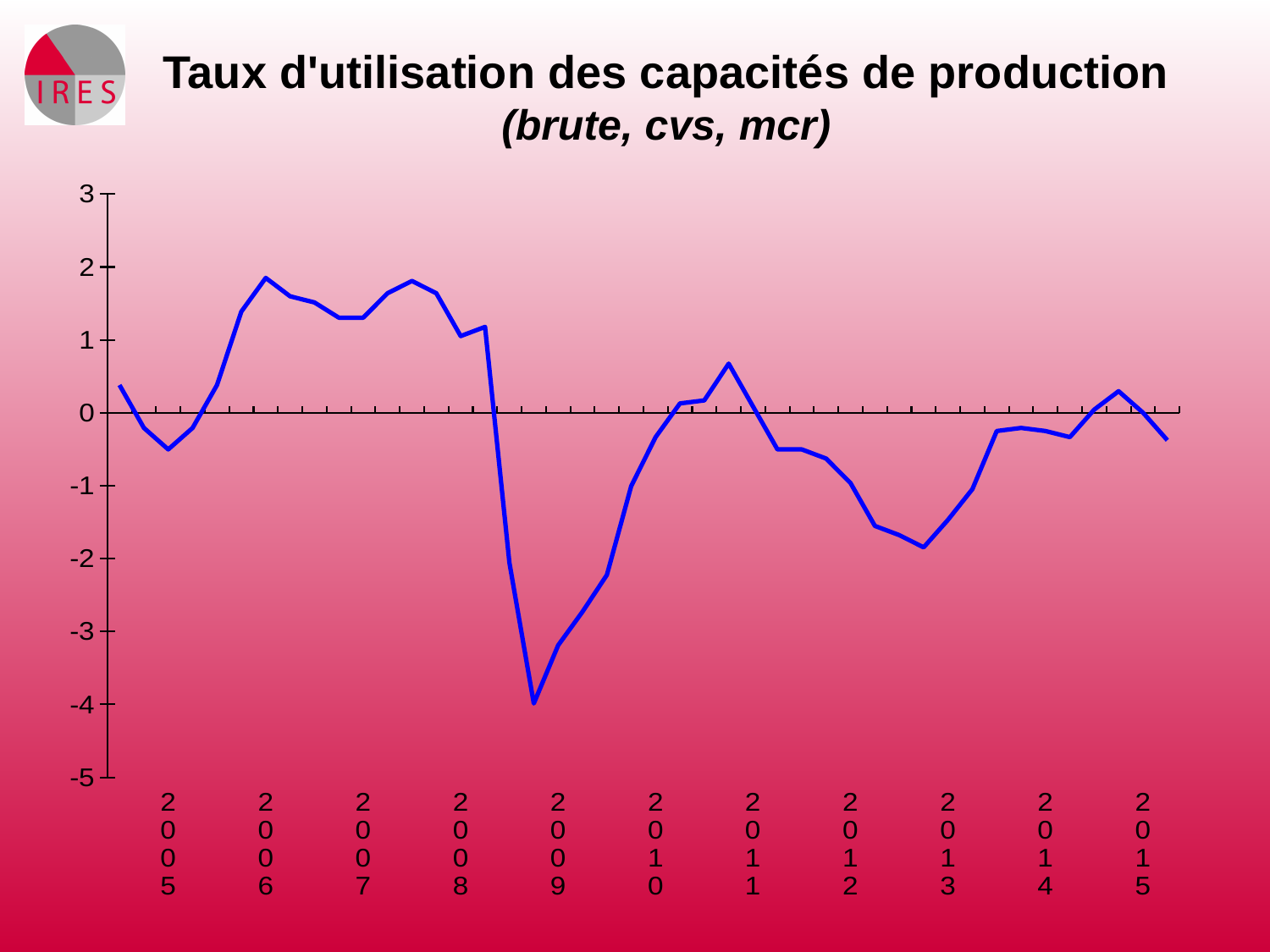
Is the lowest value of the line, reached in 2009, greater or less than -3? less What are the lowest and highest values marked on the y axis? -5 and 3 What is the title of the chart? Taux d'utilisation des capacités de production What kind of chart is shown on the slide? line chart Is the trough of the line around 2013 greater or less than -1? less What subtitle appears in italics under the chart title? (brute, cvs, mcr) Which year shows the deeper trough, 2009 or 2013? 2009 Does the line rise or fall between 2008 and 2009? fall In which year does the line reach its lowest point? 2009 How many year labels are shown on the x axis? 11 Is the peak of the line around 2006 greater or less than 1? greater Does the line rise or fall between 2009 and 2011? rise